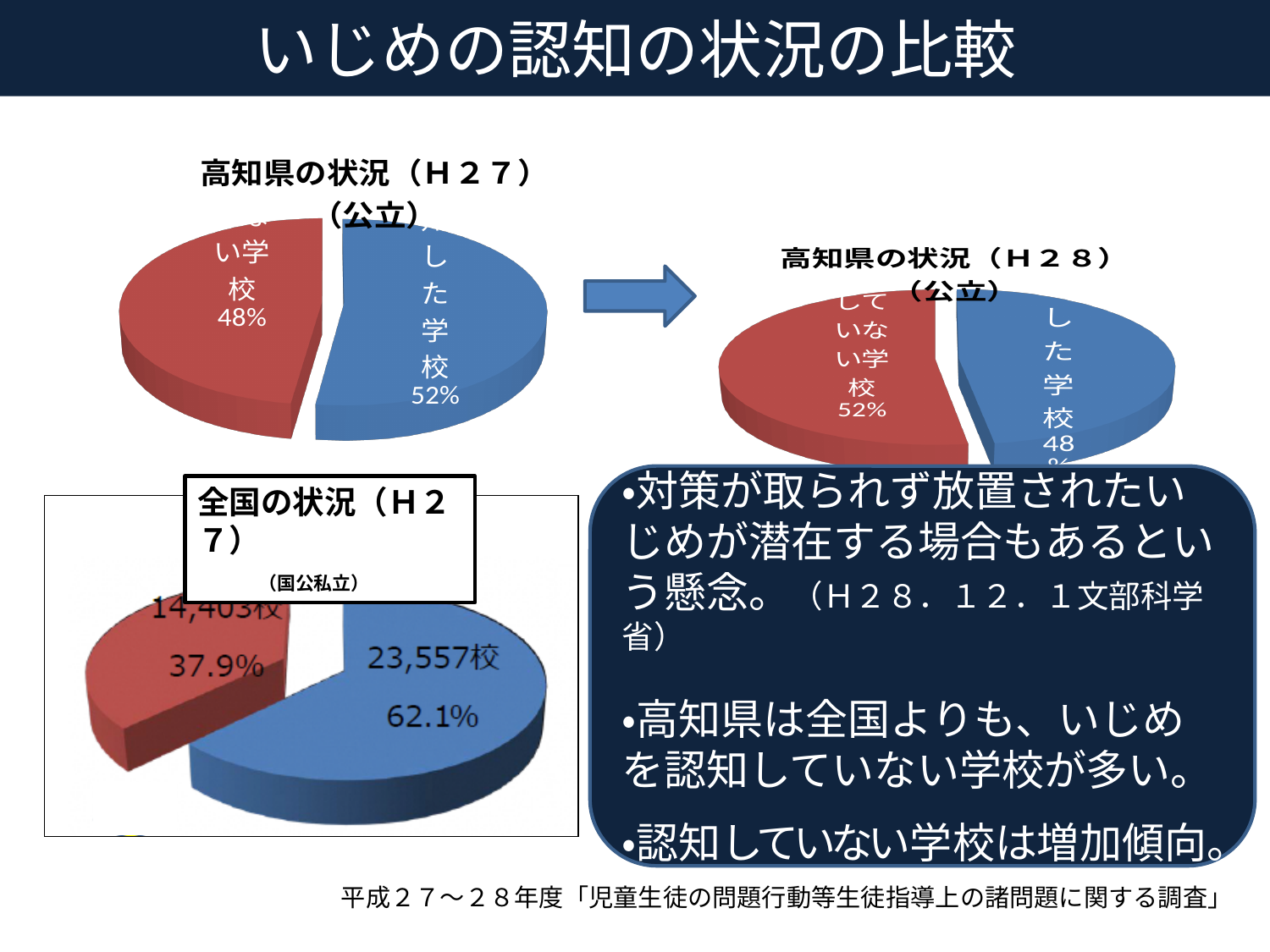
In the 全国の状況（H27） pie chart, how many schools does the blue slice represent? 23,557校 In the 全国の状況（H27） pie chart, how many schools does the red slice represent? 14,403校 How many pie charts are shown on the slide? 3 In the 高知県の状況（H27）（公立） pie chart, what percentage is shown for the した学校 (blue) slice? 52% How many slices does the 全国の状況（H27） pie chart have? 2 In the 高知県の状況（H27）（公立） pie chart, what percentage is shown for the red slice (していない学校)? 48% In the 高知県の状況（H27）（公立） pie chart, which slice is the largest? した学校 (blue), 52% In the 高知県の状況（H28）（公立） pie chart, what percentage is shown for the していない学校 (red) slice? 52% In the 高知県の状況（H28）（公立） pie chart, which slice is larger, the red (していない学校) or the blue (した学校)? red (していない学校) In the 全国の状況（H27） pie chart, what percentage is shown for the blue slice? 62.1% What type of chart is used for 全国の状況（H27）? pie chart In the 全国の状況（H27） pie chart, what is the difference in percentage points between the blue slice and the red slice? 24.2